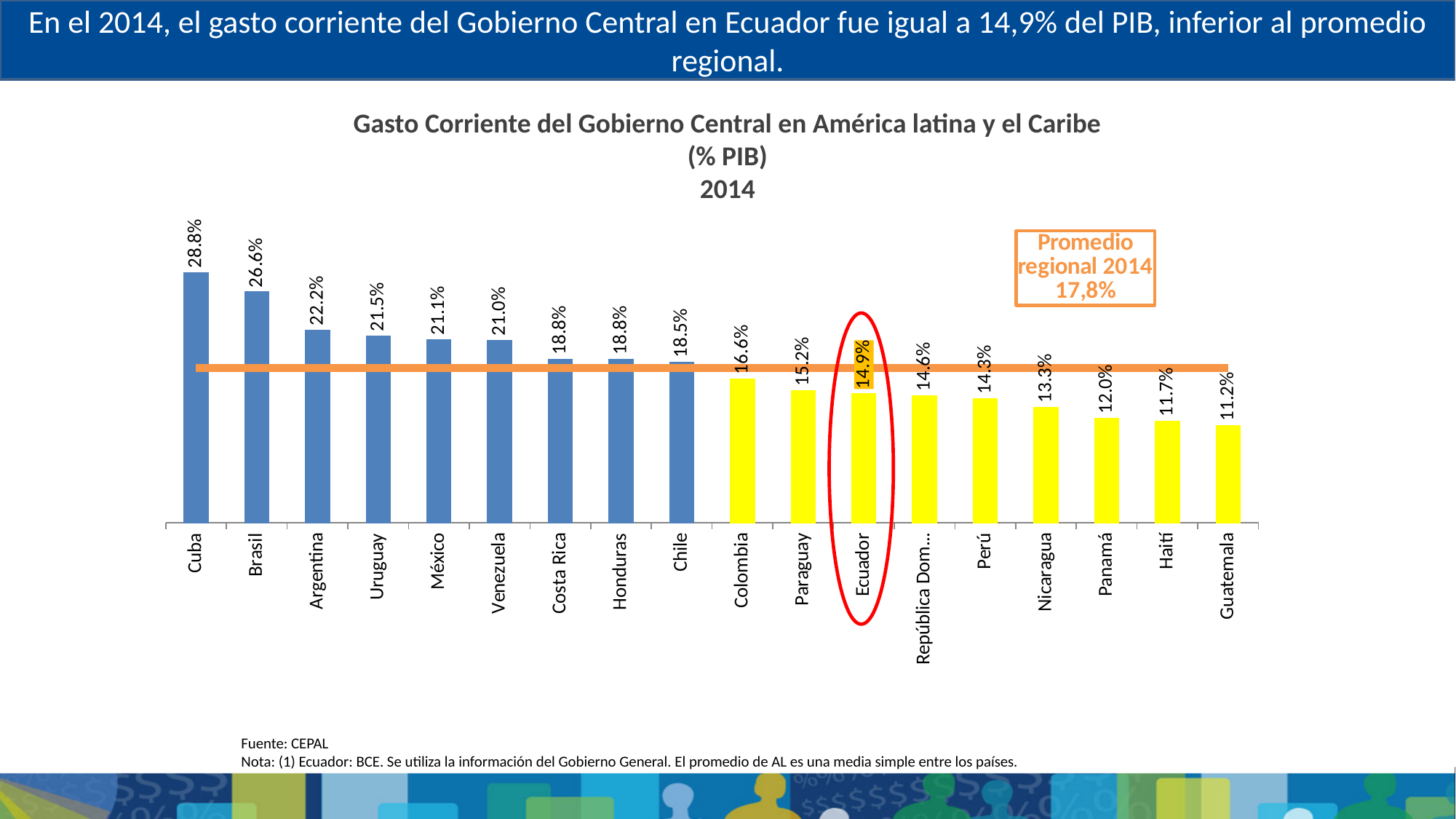
How many countries are shown in the chart? 18 What kind of chart is shown on the slide? Bar chart What is the regional average for 2014 shown in the orange box? 17,8% Which country has the highest value in the chart? Cuba Which country has the lowest value in the chart? Guatemala Which is larger, the value for Argentina or the value for Chile? Argentina What is the value for Cuba in the chart? 28.8% What is the value for Ecuador in the chart? 14.9% Do the values rise or fall from left to right along the x axis? Fall What is the difference between the values for Cuba and Brasil? 2.2% What is the difference between the values for Colombia and Ecuador? 1.7% What is the value for Perú in the chart? 14.3%